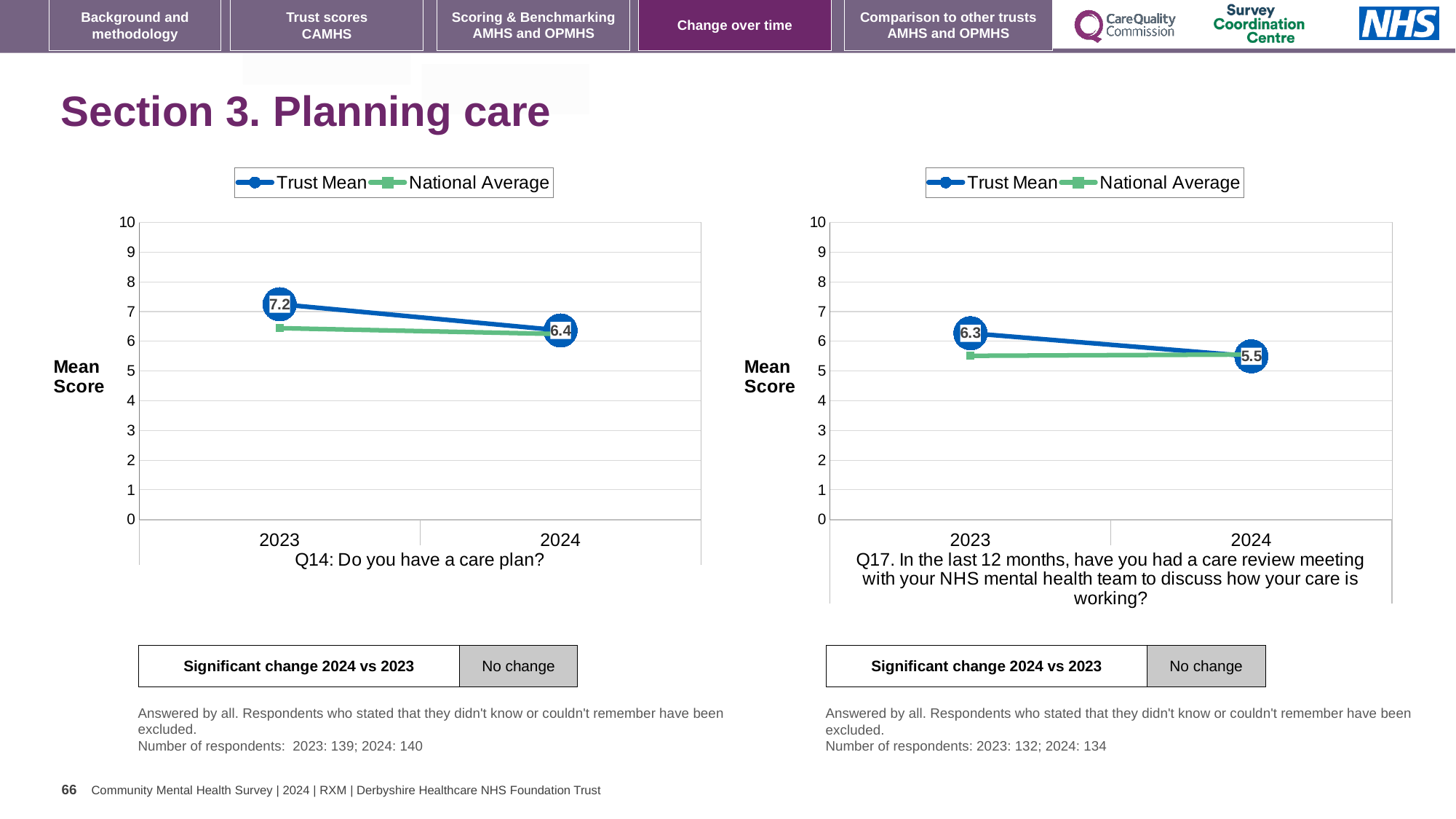
In the Q17 chart (right), what is the Trust Mean for 2024? 5.5 In the Q14 chart (left), does the Trust Mean rise or fall from 2023 to 2024? fall In the Q17 chart (right), what is the Trust Mean for 2023? 6.3 In the Q17 chart (right), is the National Average for 2023 greater or less than 6? less How many series does the legend of the Q17 chart (right) list? 2 In the Q14 chart (left), what is the Trust Mean for 2024? 6.4 In the Q14 chart (left), what is the Trust Mean for 2023? 7.2 In the Q14 chart (left), by how much did the Trust Mean change from 2023 to 2024? 0.8 What type of chart is the Q14 chart on the left? line chart In the Q17 chart (right), what is the difference between the Trust Mean in 2023 and 2024? 0.8 In the Q14 chart (left), which is larger in 2023: the Trust Mean or the National Average? Trust Mean In the Q17 chart (right), does the Trust Mean rise or fall from 2023 to 2024? fall